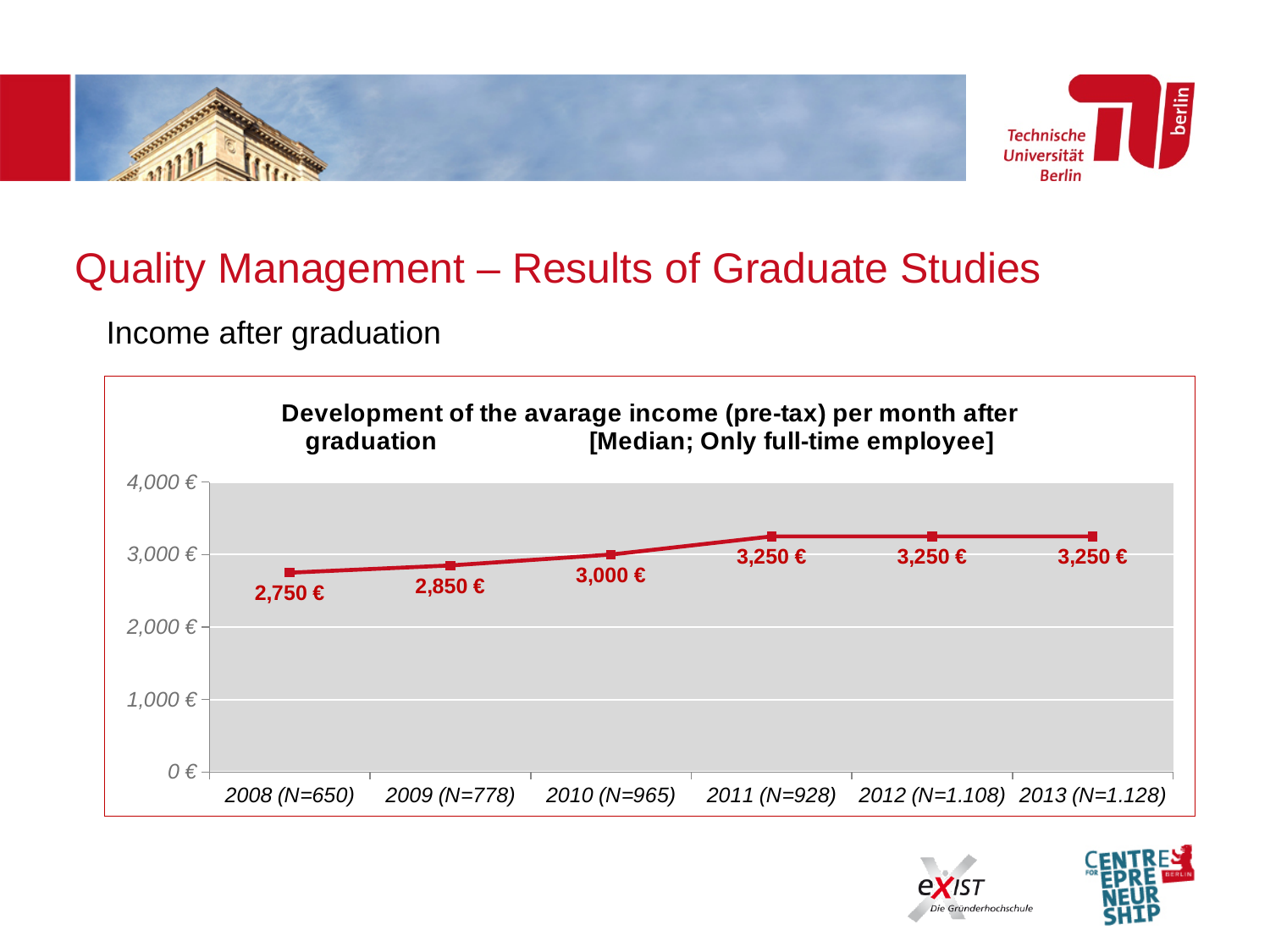
What is the highest value shown on the vertical axis of the chart? 4,000 € How many years (data points) are plotted on the chart? 6 Is the income value for 2012 (N=1.108) greater or less than 3,000 €? greater Which year has the lowest average income on the chart? 2008 (N=650) What is the average income value shown for 2013 (N=1.128)? 3,250 € What kind of chart is shown on the slide? Line chart What is the average income value shown for 2010 (N=965)? 3,000 € Do the income values rise or fall from 2008 to 2011? Rise What is the average income value shown for 2008 (N=650)? 2,750 € What is the difference between the income values for 2011 (N=928) and 2008 (N=650)? 500 € Which is larger, the income value for 2010 (N=965) or for 2009 (N=778)? 2010 (N=965) What is the difference between the income values for 2009 (N=778) and 2008 (N=650)? 100 €